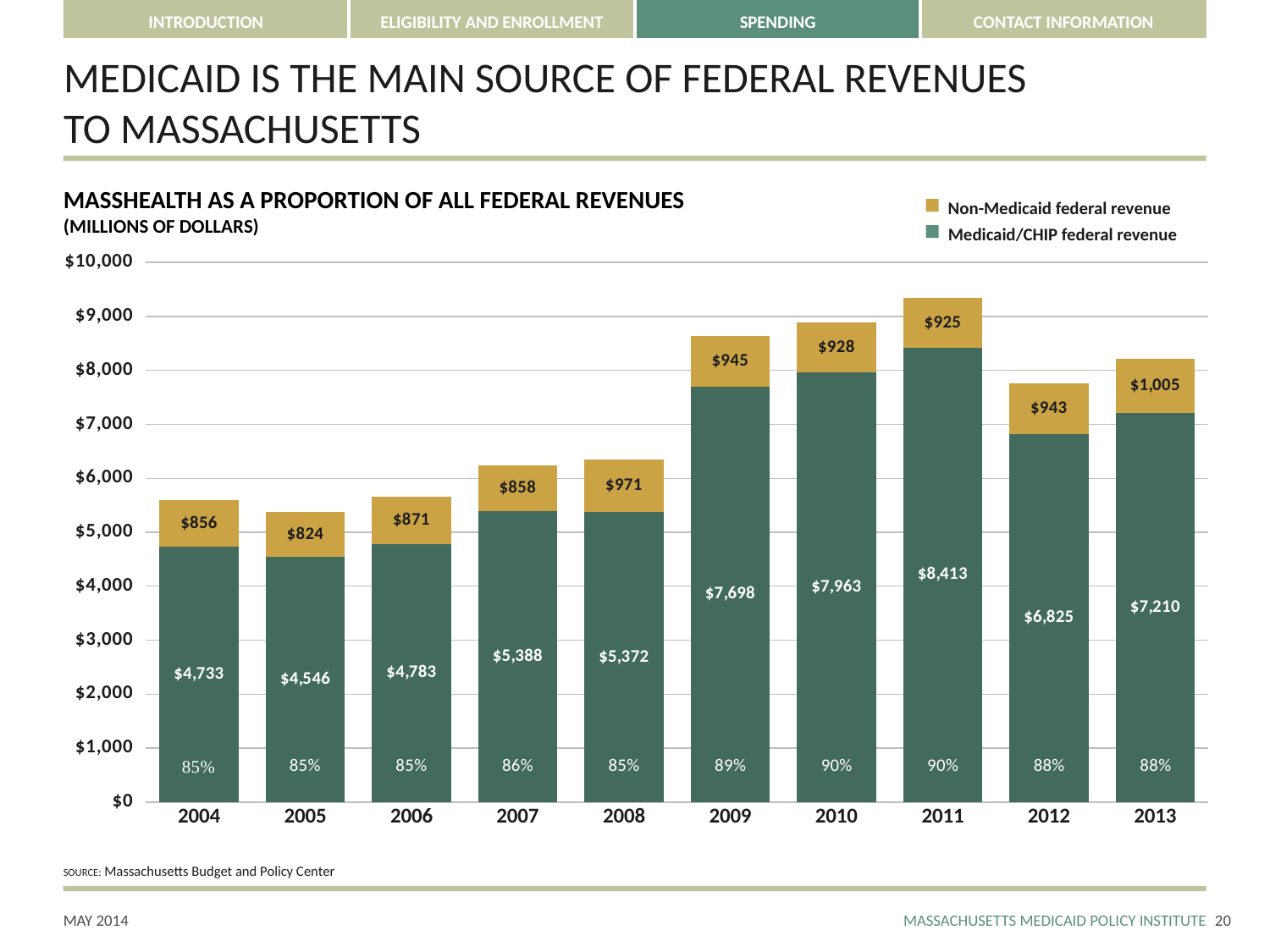
How many years are shown on the x axis? 10 Which year has the highest Medicaid/CHIP federal revenue? 2011 Which is larger, the Non-Medicaid federal revenue in 2008 or in 2009? 2008 What kind of chart is shown on the slide? Stacked bar chart What is the total of the stacked bar for 2004? $5,589 Is the total of the stacked bar for 2011 greater or less than $9,000? greater What is the Medicaid/CHIP federal revenue for 2011? $8,413 How many series does the legend list? 2 What percentage label is shown on the 2010 bar? 90% What is the Non-Medicaid federal revenue for 2013? $1,005 Which year has the lowest Medicaid/CHIP federal revenue? 2005 What is the difference between the Medicaid/CHIP federal revenue in 2011 and in 2012? $1,588